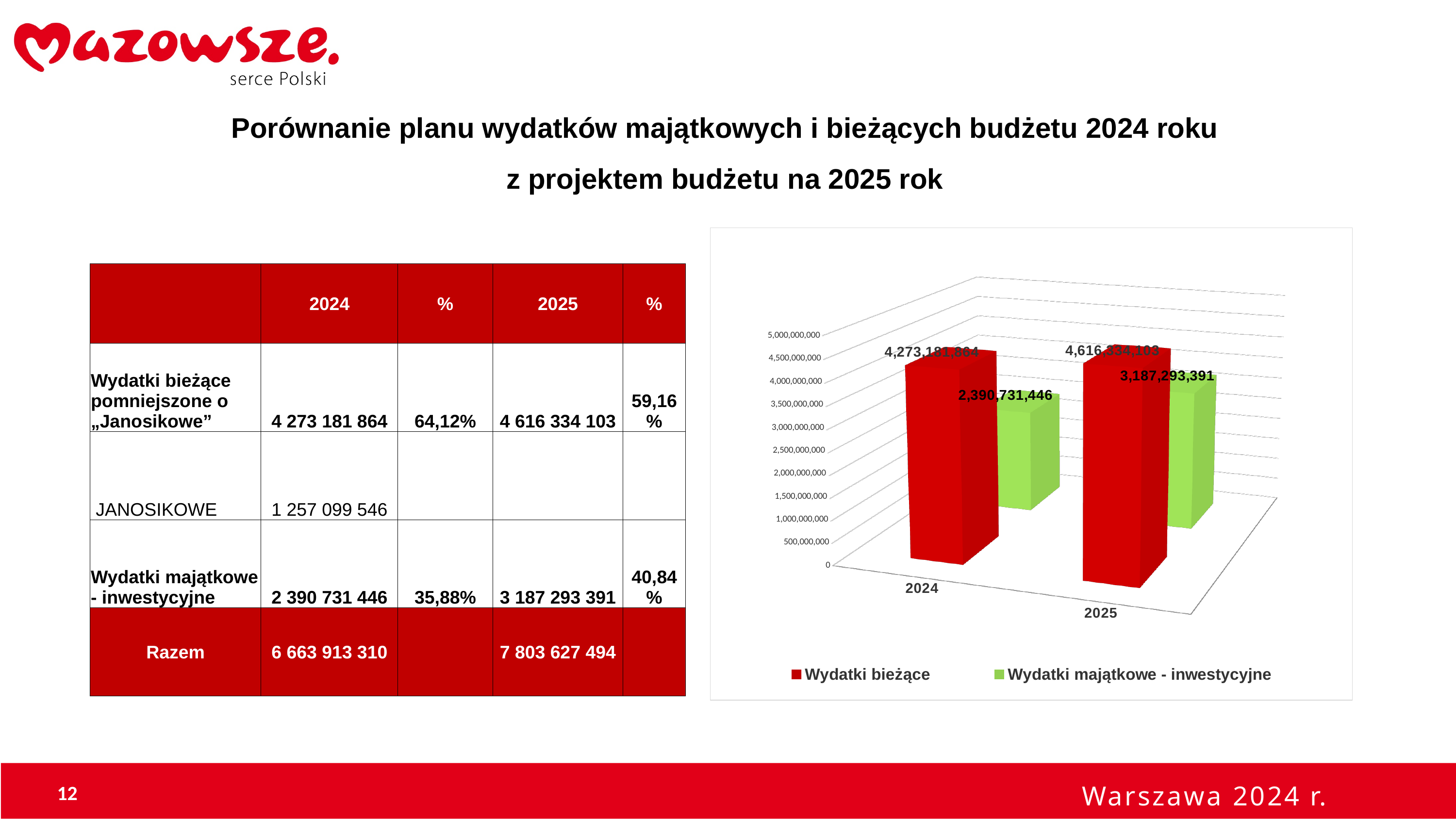
Which colour represents Wydatki bieżące in the chart? red Do the values for Wydatki majątkowe - inwestycyjne rise or fall from 2024 to 2025? rise Which year has the higher value for Wydatki bieżące in the chart? 2025 What is the value of Wydatki majątkowe - inwestycyjne for 2025 in the chart? 3,187,293,391 What is the value of Wydatki bieżące for 2024 in the chart? 4,273,181,864 How many year categories are shown on the chart's x axis? 2 Which bar in the chart has the lowest value? Wydatki majątkowe - inwestycyjne, 2024 What is the difference between Wydatki majątkowe - inwestycyjne in 2025 and in 2024 in the chart? 796,561,945 What kind of chart is shown on the slide? bar chart What is the value of Wydatki majątkowe - inwestycyjne for 2024 in the chart? 2,390,731,446 How many series does the chart legend list? 2 By how much does Wydatki bieżące in 2025 exceed Wydatki bieżące in 2024 in the chart? 343,152,239